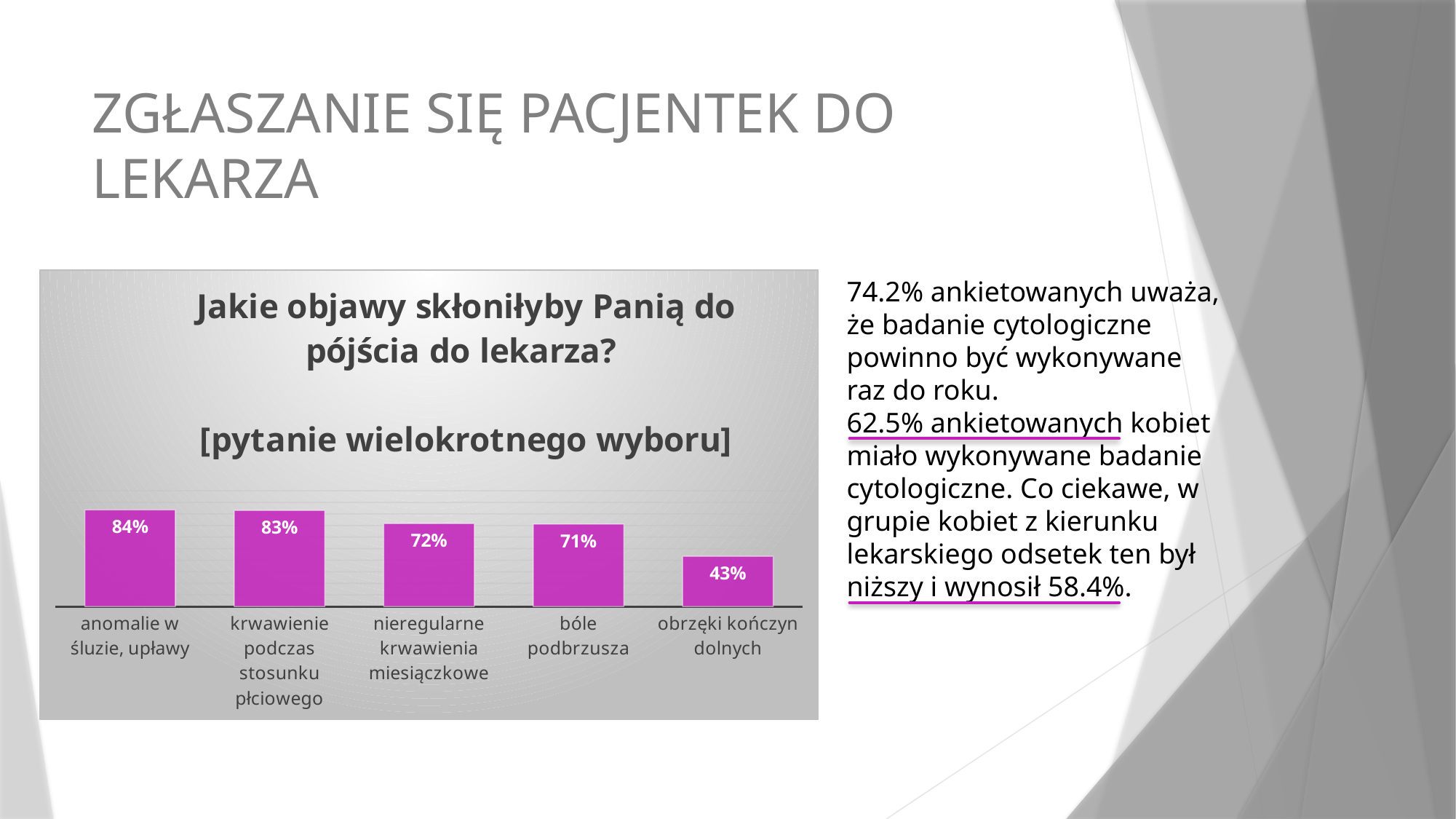
What is the value for "bóle podbrzusza"? 71% What is the difference between the values for "krwawienie podczas stosunku płciowego" and "bóle podbrzusza"? 12% Which category has the lowest value? obrzęki kończyn dolnych What is the value for "obrzęki kończyn dolnych"? 43% How many categories are shown in the chart? 5 Which is larger: the value for "nieregularne krwawienia miesiączkowe" or the value for "obrzęki kończyn dolnych"? nieregularne krwawienia miesiączkowe Do the values rise or fall from left to right along the x axis? fall What is the value for "nieregularne krwawienia miesiączkowe"? 72% What is the title of the chart? Jakie objawy skłoniłyby Panią do pójścia do lekarza? [pytanie wielokrotnego wyboru] What kind of chart is shown on the slide? bar chart What is the difference between the values for "anomalie w śluzie, upławy" and "obrzęki kończyn dolnych"? 41% What is the value for "anomalie w śluzie, upławy"? 84%